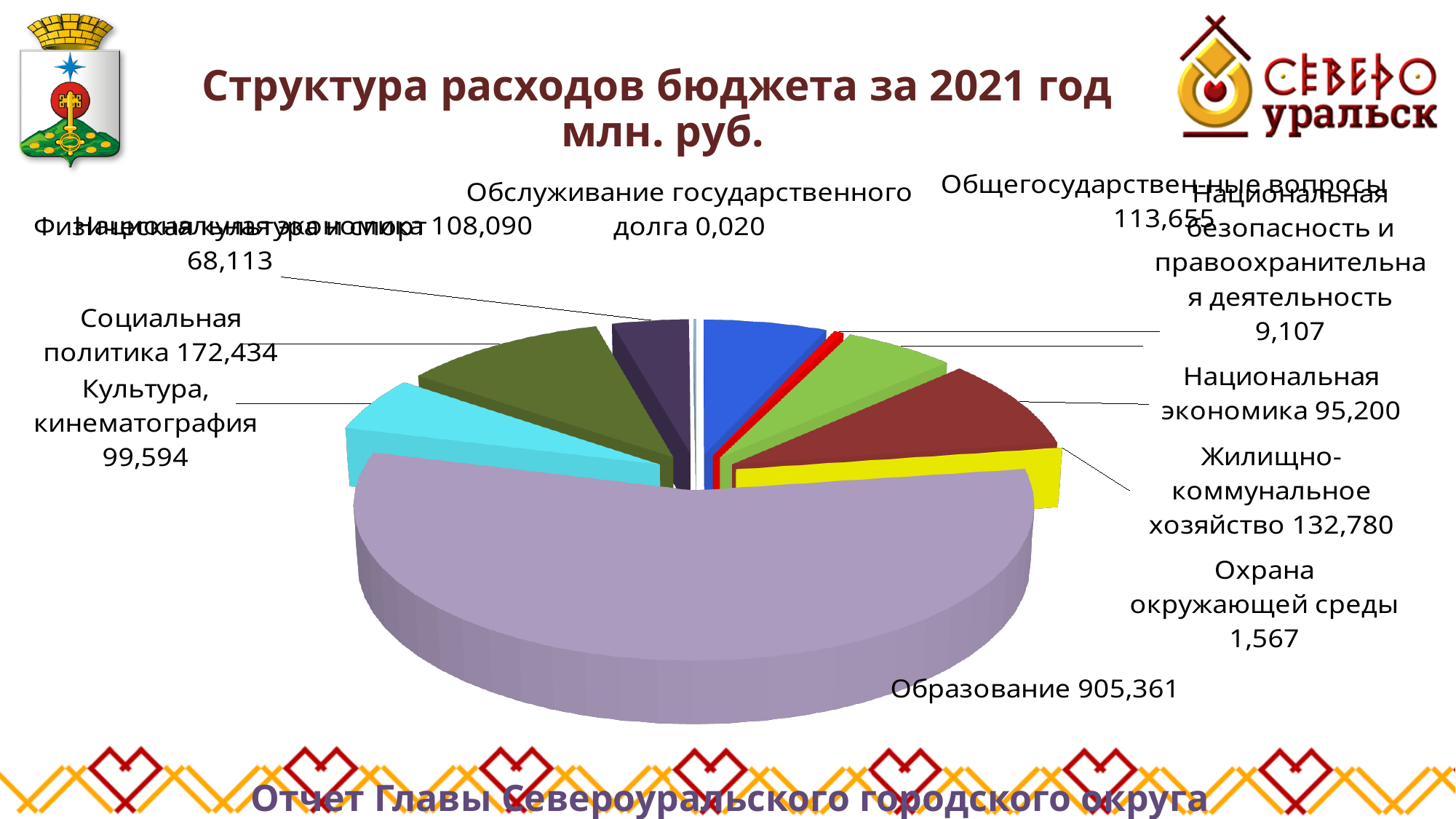
What is the value for Общегосударственные вопросы? 113,655 Which category has the smallest value? Обслуживание государственного долга What is the value for Охрана окружающей среды? 1,567 What kind of chart is shown on the slide? pie chart What is the value for Жилищно-коммунальное хозяйство? 132,780 What is the difference between Социальная политика and Жилищно-коммунальное хозяйство? 39,654 Which is larger, Социальная политика or Жилищно-коммунальное хозяйство? Социальная политика What is the title of the chart? Структура расходов бюджета за 2021 год млн. руб. What is the value for Образование? 905,361 What is the value for Социальная политика? 172,434 Which category has the largest slice of the pie? Образование What is the value for Обслуживание государственного долга? 0,020